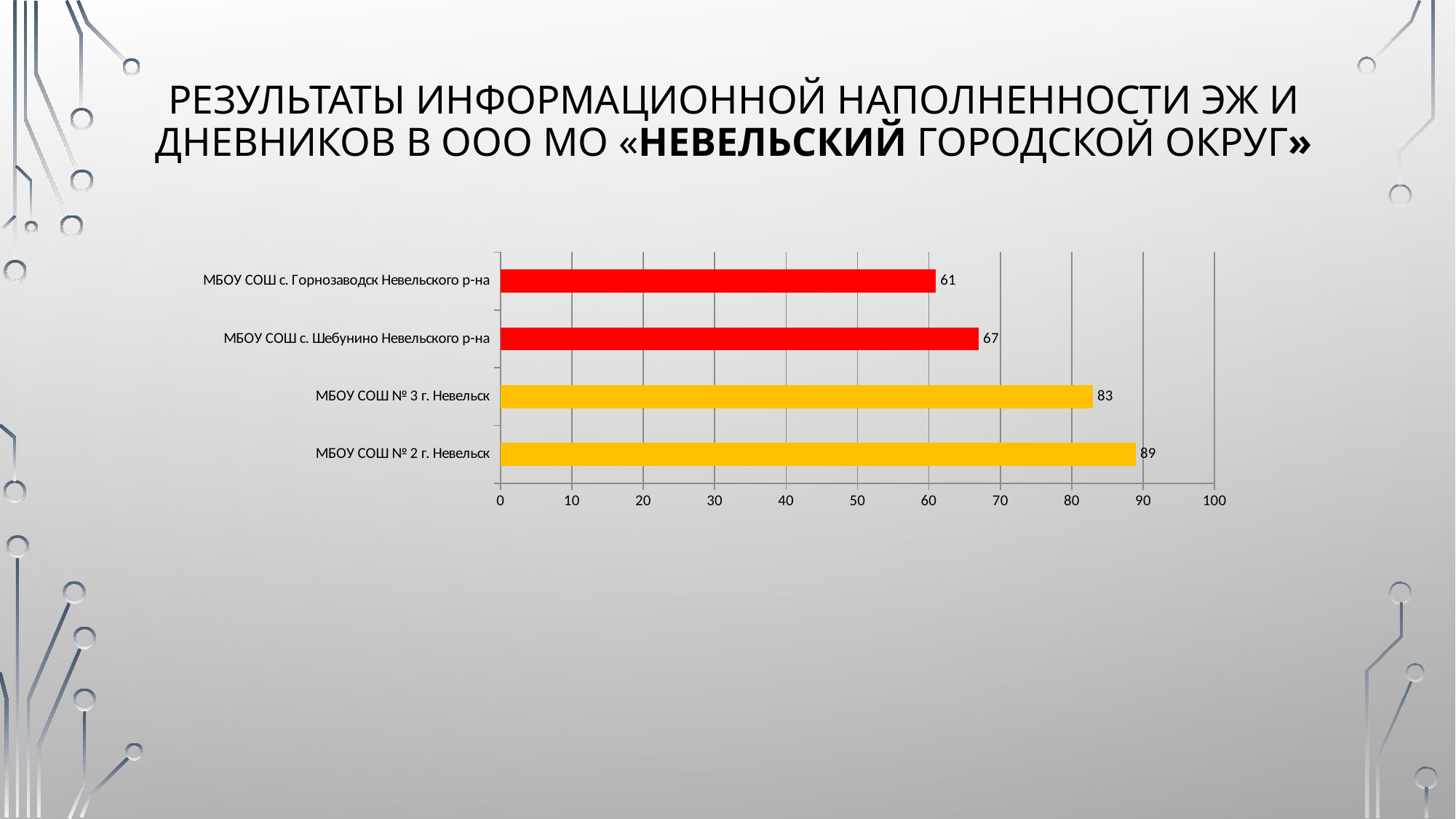
What is the value for МБОУ СОШ с. Горнозаводск Невельского р-на? 61 What kind of chart is shown on the slide? Bar chart What is the difference between the values for МБОУ СОШ № 3 г. Невельск and МБОУ СОШ с. Шебунино Невельского р-на? 16 What is the difference between the values for МБОУ СОШ № 2 г. Невельск and МБОУ СОШ с. Горнозаводск Невельского р-на? 28 Which school has the highest value? МБОУ СОШ № 2 г. Невельск What colour are the bars for the two schools in г. Невельск? Yellow Which school has the lowest value? МБОУ СОШ с. Горнозаводск Невельского р-на What is the value for МБОУ СОШ № 3 г. Невельск? 83 What is the value for МБОУ СОШ с. Шебунино Невельского р-на? 67 How many schools are shown in the chart? 4 What is the value for МБОУ СОШ № 2 г. Невельск? 89 Which has a larger value, МБОУ СОШ с. Шебунино Невельского р-на or МБОУ СОШ № 3 г. Невельск? МБОУ СОШ № 3 г. Невельск